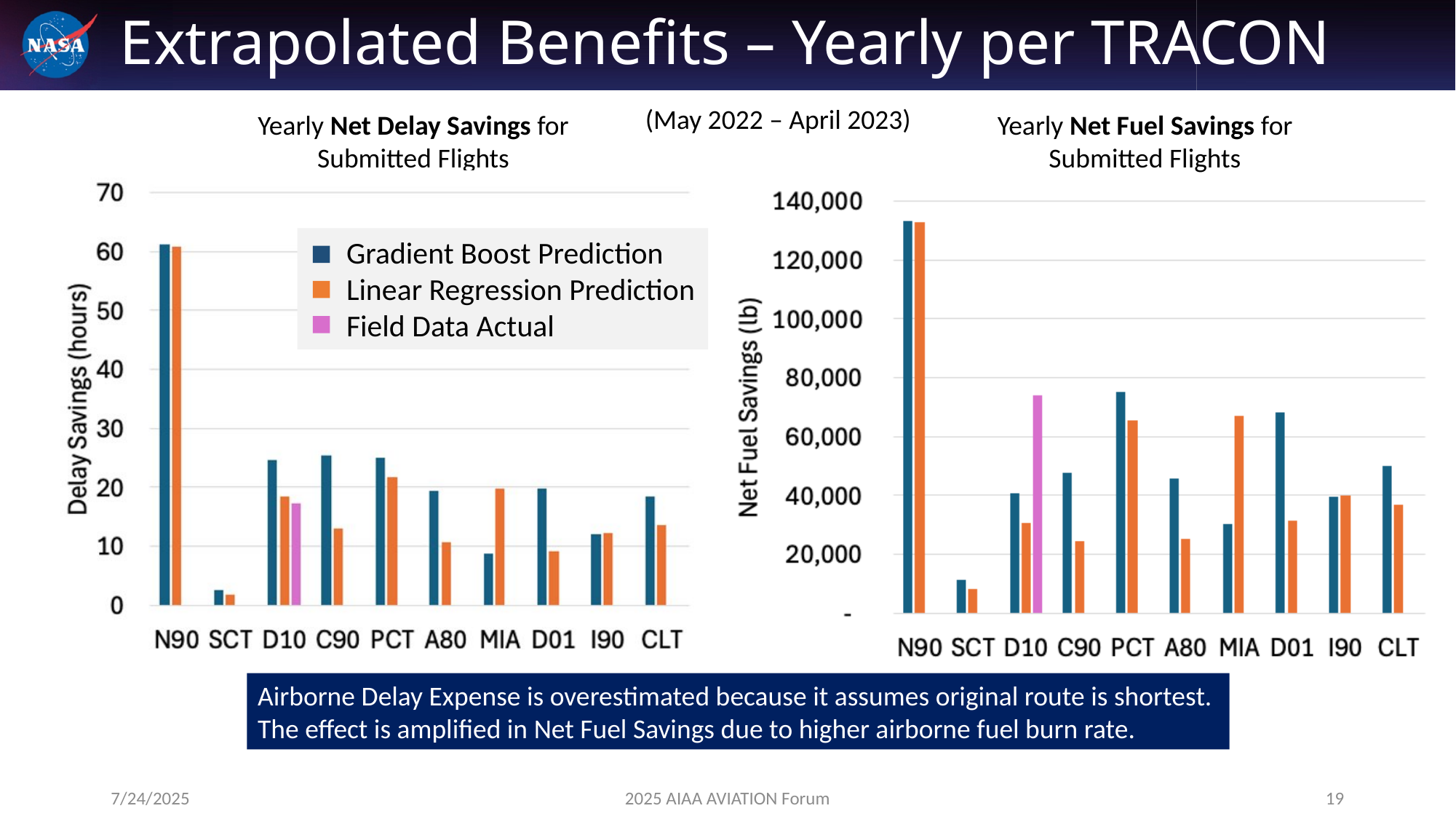
How many TRACON categories are shown on the x axis of the Yearly Net Delay Savings chart? 10 In the Yearly Net Delay Savings chart, which TRACON has the lowest Gradient Boost Prediction? SCT In the Yearly Net Fuel Savings chart, which TRACON has the lowest Gradient Boost Prediction? SCT In the Yearly Net Delay Savings chart, which TRACON has the highest Gradient Boost Prediction? N90 In the Yearly Net Fuel Savings chart, which is larger for D01: the Gradient Boost Prediction or the Linear Regression Prediction? Gradient Boost Prediction In the Yearly Net Fuel Savings chart, which TRACON has the highest Linear Regression Prediction? N90 Which TRACON is the only one with a Field Data Actual bar in both charts? D10 What kind of chart is the Yearly Net Delay Savings chart on the left? bar chart How many series does the legend list? 3 In the Yearly Net Fuel Savings chart, is the Gradient Boost Prediction for PCT greater or less than 60,000? greater In the Yearly Net Delay Savings chart, is the Gradient Boost Prediction for N90 greater or less than 50? greater In the Yearly Net Delay Savings chart, which is larger for MIA: the Gradient Boost Prediction or the Linear Regression Prediction? Linear Regression Prediction